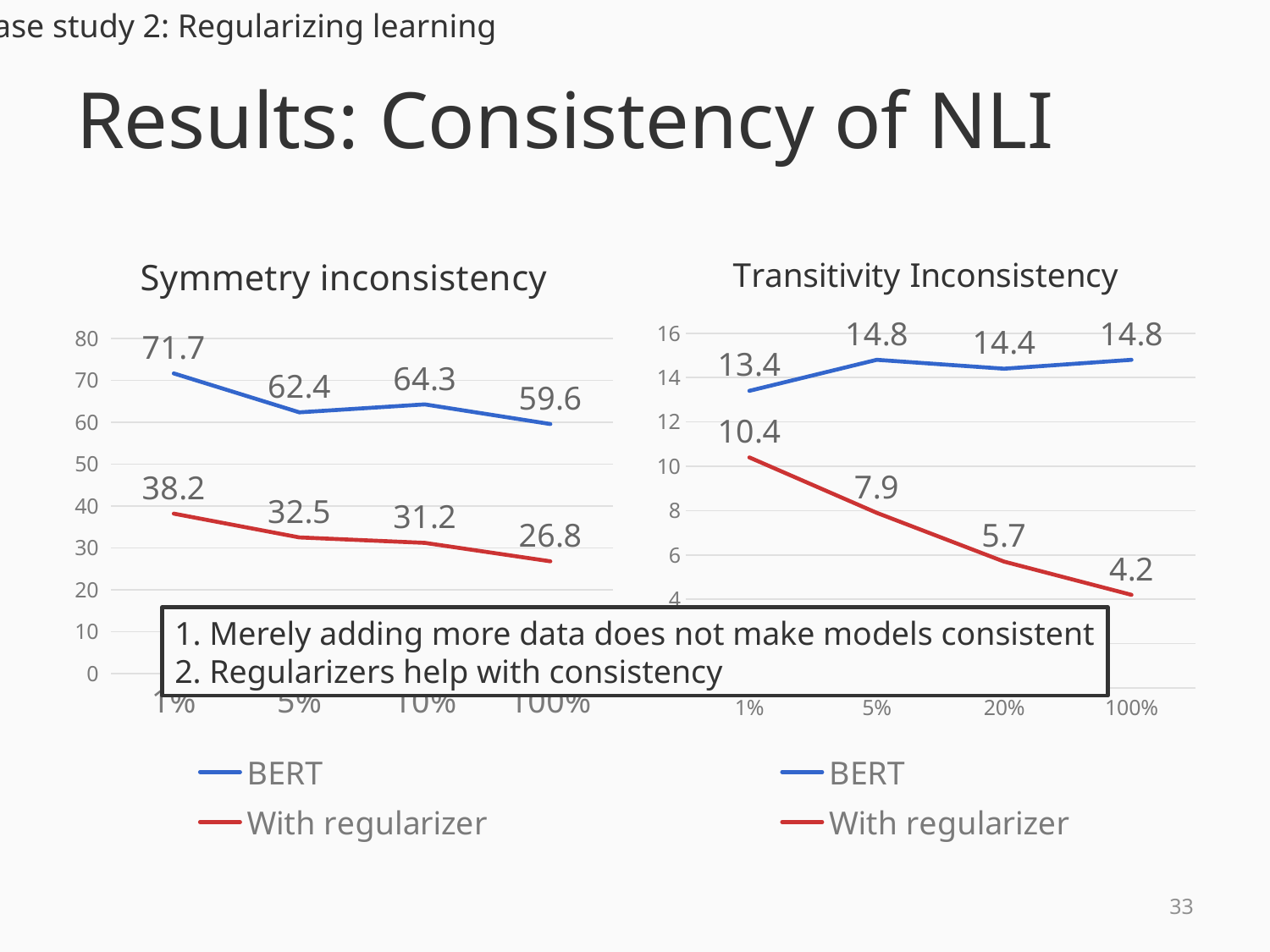
In the Transitivity Inconsistency chart, what is the With regularizer value at 20%? 5.7 In the Transitivity Inconsistency chart, at which x-axis point is the With regularizer series highest? 1% In the Transitivity Inconsistency chart, what is the difference between the With regularizer values at 1% and 100%? 6.2 In the Transitivity Inconsistency chart, does the With regularizer series rise or fall from 1% to 100%? Fall In the Symmetry inconsistency chart, which is larger: the BERT value at 5% or at 10%? 10% In the Symmetry inconsistency chart, what is the difference between BERT and With regularizer at 100%? 32.8 In the Symmetry inconsistency chart, what is the With regularizer value at 100%? 26.8 In the Symmetry inconsistency chart, at which x-axis point is the With regularizer series lowest? 100% How many series does the legend of the Symmetry inconsistency chart list? 2 What kind of chart is the Transitivity Inconsistency chart? Line chart In the Symmetry inconsistency chart, what is the BERT value at 1%? 71.7 In the Transitivity Inconsistency chart, what is the BERT value at 1%? 13.4